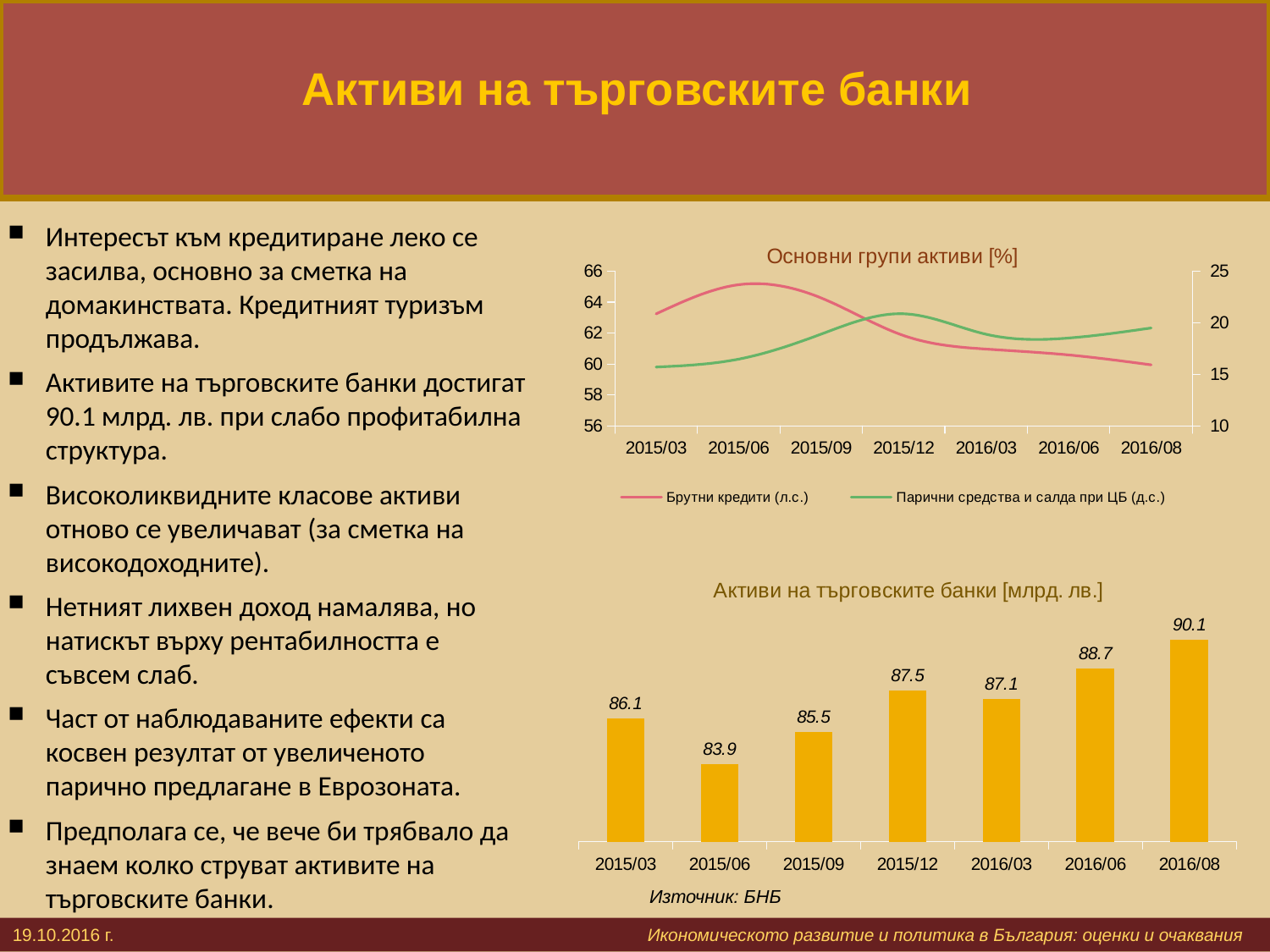
In the chart 'Активи на търговските банки [млрд. лв.]', what is the value for 2015/06? 83.9 What kind of chart is 'Основни групи активи [%]'? line chart In the chart 'Активи на търговските банки [млрд. лв.]', what is the value for 2016/08? 90.1 In the chart 'Основни групи активи [%]', is the value of 'Брутни кредити (л.с.)' at 2016/08 greater or less than 62? less In the chart 'Активи на търговските банки [млрд. лв.]', which is larger: the value for 2015/12 or the value for 2016/03? 2015/12 In the chart 'Активи на търговските банки [млрд. лв.]', which period has the highest value? 2016/08 What kind of chart is 'Активи на търговските банки [млрд. лв.]'? bar chart In the chart 'Активи на търговските банки [млрд. лв.]', what is the difference between the values for 2016/08 and 2015/03? 4.0 In the chart 'Основни групи активи [%]', does the 'Брутни кредити (л.с.)' line rise or fall between 2015/06 and 2016/08? fall How many bars are in the chart 'Активи на търговските банки [млрд. лв.]'? 7 How many series does the legend of the chart 'Основни групи активи [%]' list? 2 In the chart 'Активи на търговските банки [млрд. лв.]', which period has the lowest value? 2015/06